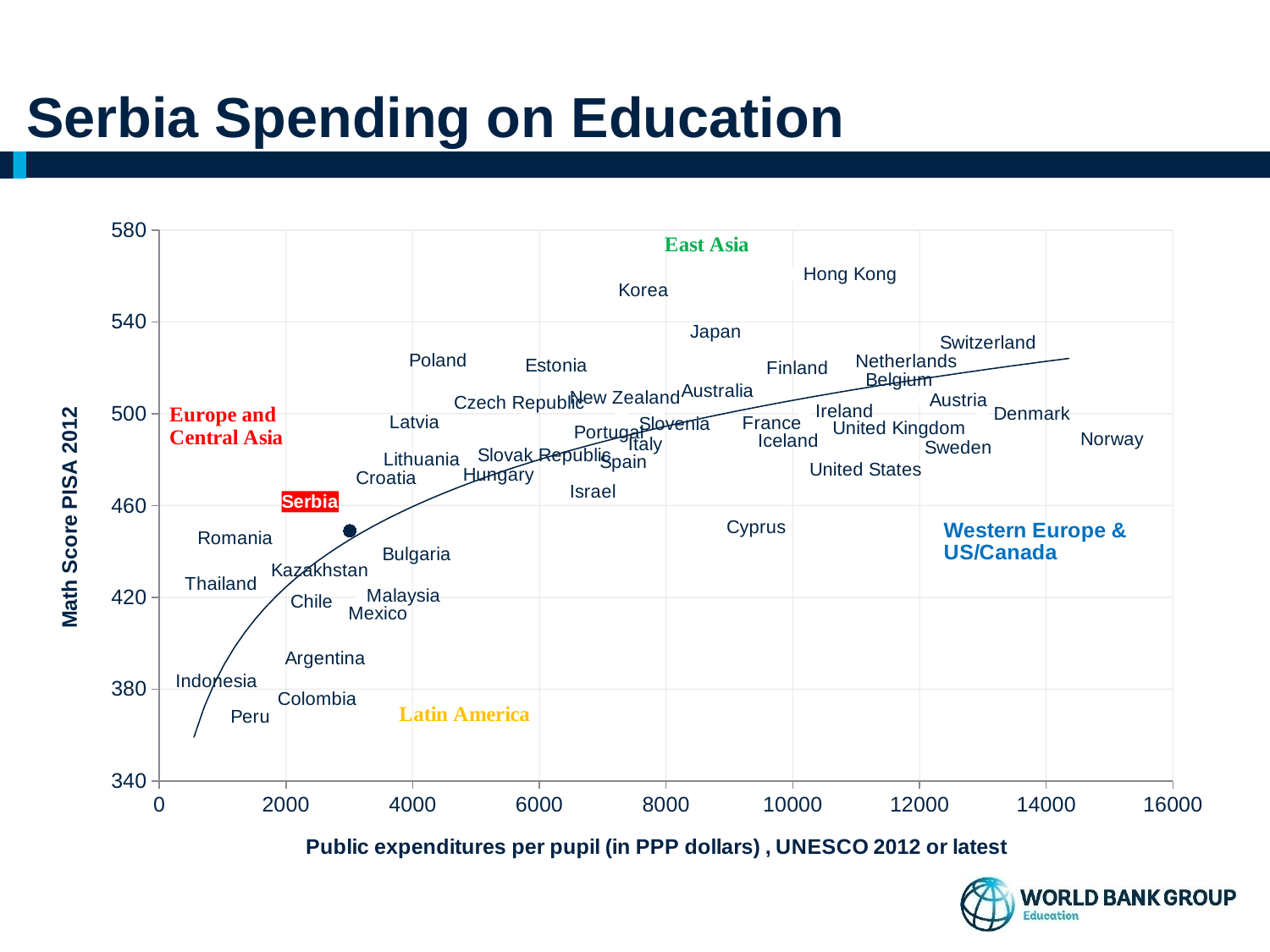
What kind of chart is shown on the slide? scatter chart Is the math score for Hong Kong greater or less than 540? greater Which country has the lowest math score on the chart? Peru Which country has the highest public expenditure per pupil on the chart? Norway What is the label of the y axis of the chart? Math Score PISA 2012 Which has the higher math score, Korea or Cyprus? Korea What is the title of the chart on the slide? Serbia Spending on Education Does the math score generally rise or fall as public expenditure per pupil increases along the x axis? rise Which country has the highest math score on the chart? Hong Kong Is the public expenditure per pupil for Norway greater or less than 14000? greater Is the math score for Serbia greater or less than 460? less